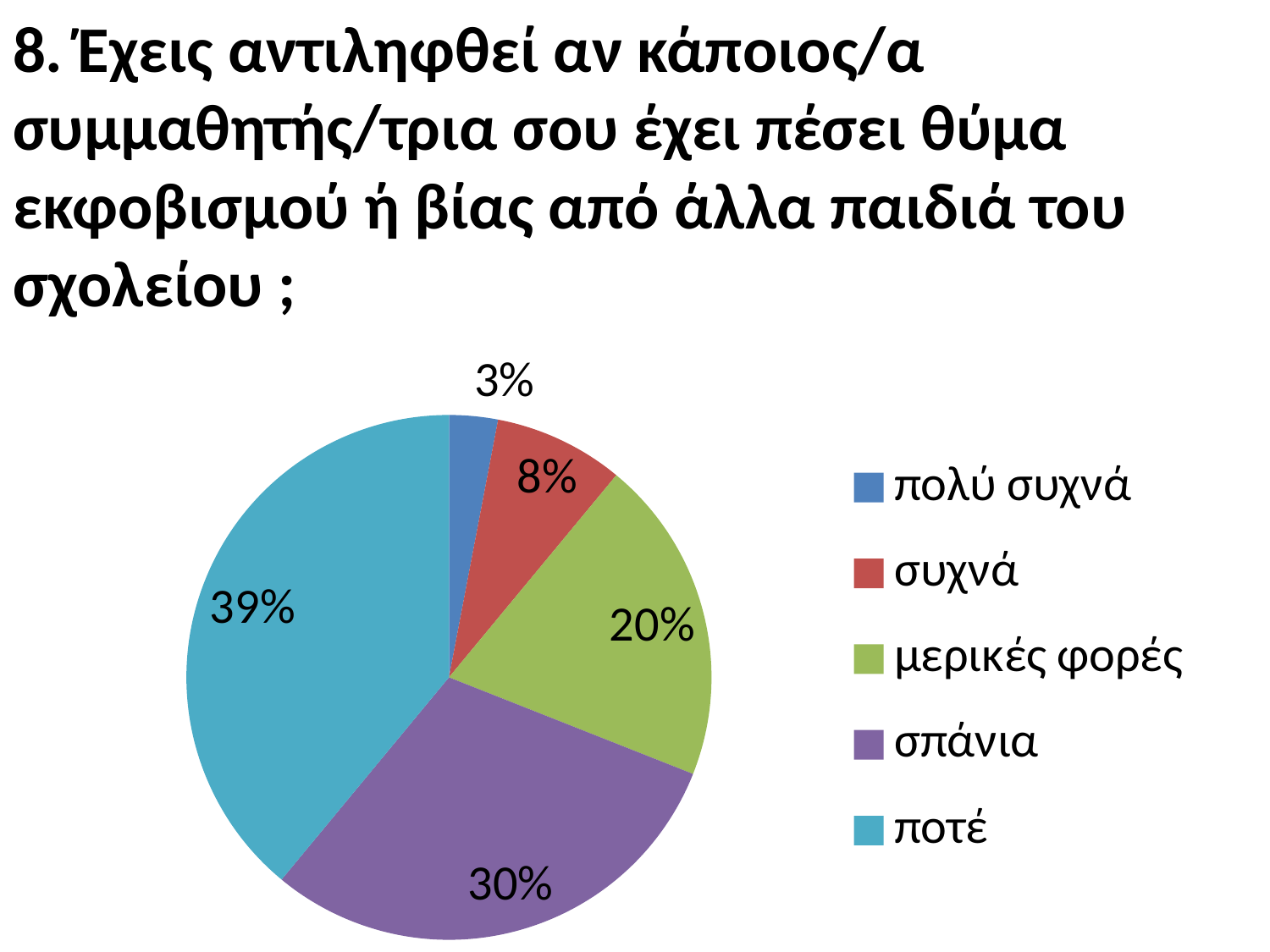
Which category has the largest slice of the pie? ποτέ What colour is the slice for "σπάνια"? purple What is the difference in percentage points between "ποτέ" and "σπάνια"? 9 Which category has the smallest slice of the pie? πολύ συχνά How many categories does the legend list? 5 What kind of chart is shown on the slide? pie chart What percentage of the pie is labelled "μερικές φορές"? 20% What percentage of the pie is labelled "σπάνια"? 30% What percentage of the pie is labelled "συχνά"? 8% What percentage of the pie is labelled "πολύ συχνά"? 3% What percentage of the pie is labelled "ποτέ"? 39% Which is larger, the slice for "μερικές φορές" or the slice for "συχνά"? μερικές φορές